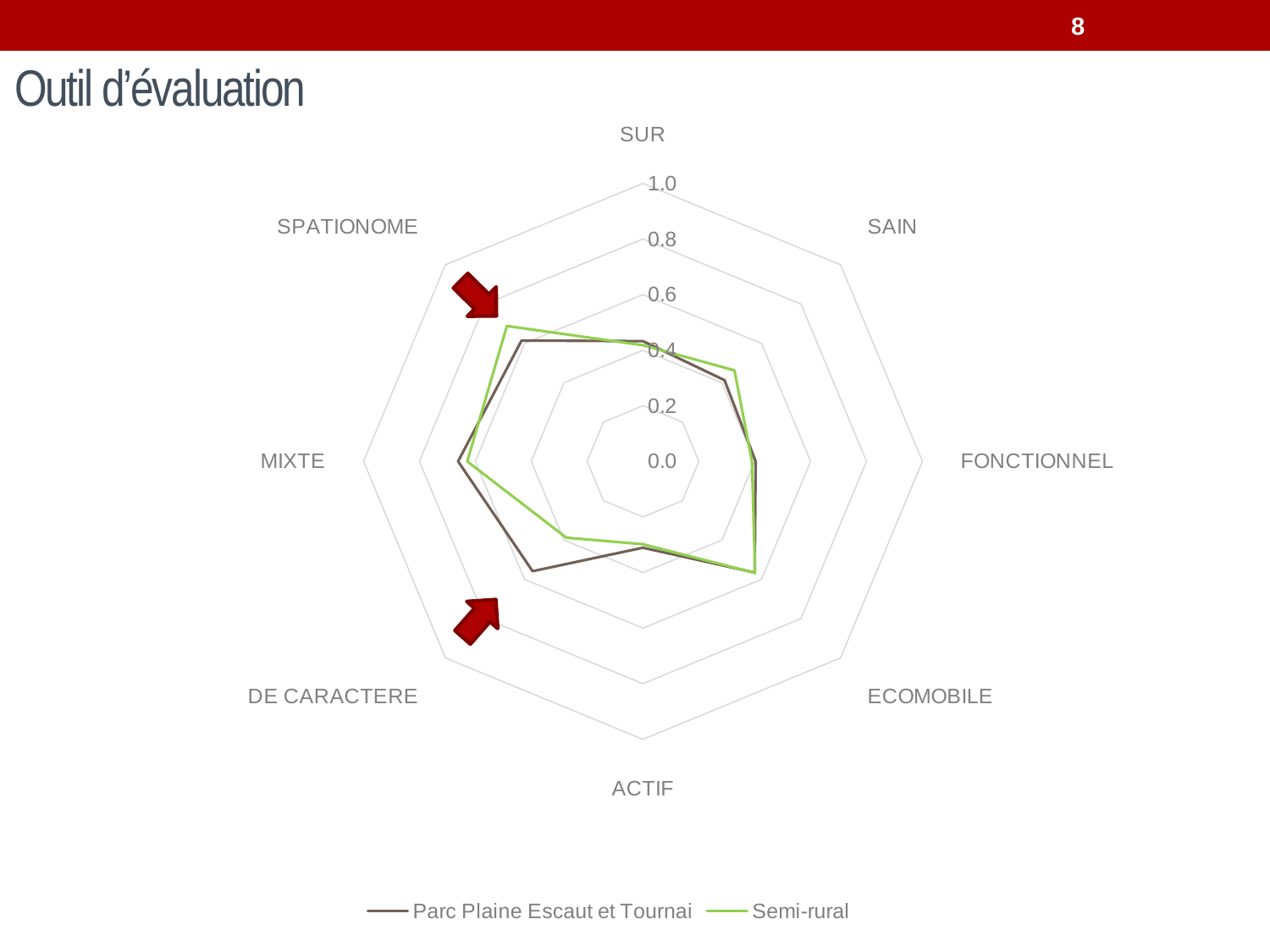
Is the value for ACTIF in the Parc Plaine Escaut et Tournai series greater or less than 0.4? less Which series is drawn in green? Semi-rural How many series does the legend list? 2 Is the value for DE CARACTERE in the Parc Plaine Escaut et Tournai series greater or less than 0.4? greater What kind of chart is shown on the slide? Radar chart Is the value for SPATIONOME in the Semi-rural series greater or less than 0.6? greater For DE CARACTERE, which series has the larger value, Parc Plaine Escaut et Tournai or Semi-rural? Parc Plaine Escaut et Tournai Which category has the lowest value for the Parc Plaine Escaut et Tournai series? ACTIF How many categories (axes) does the radar chart have? 8 What is the title of the slide containing the chart? Outil d’évaluation For SPATIONOME, which series has the larger value, Parc Plaine Escaut et Tournai or Semi-rural? Semi-rural